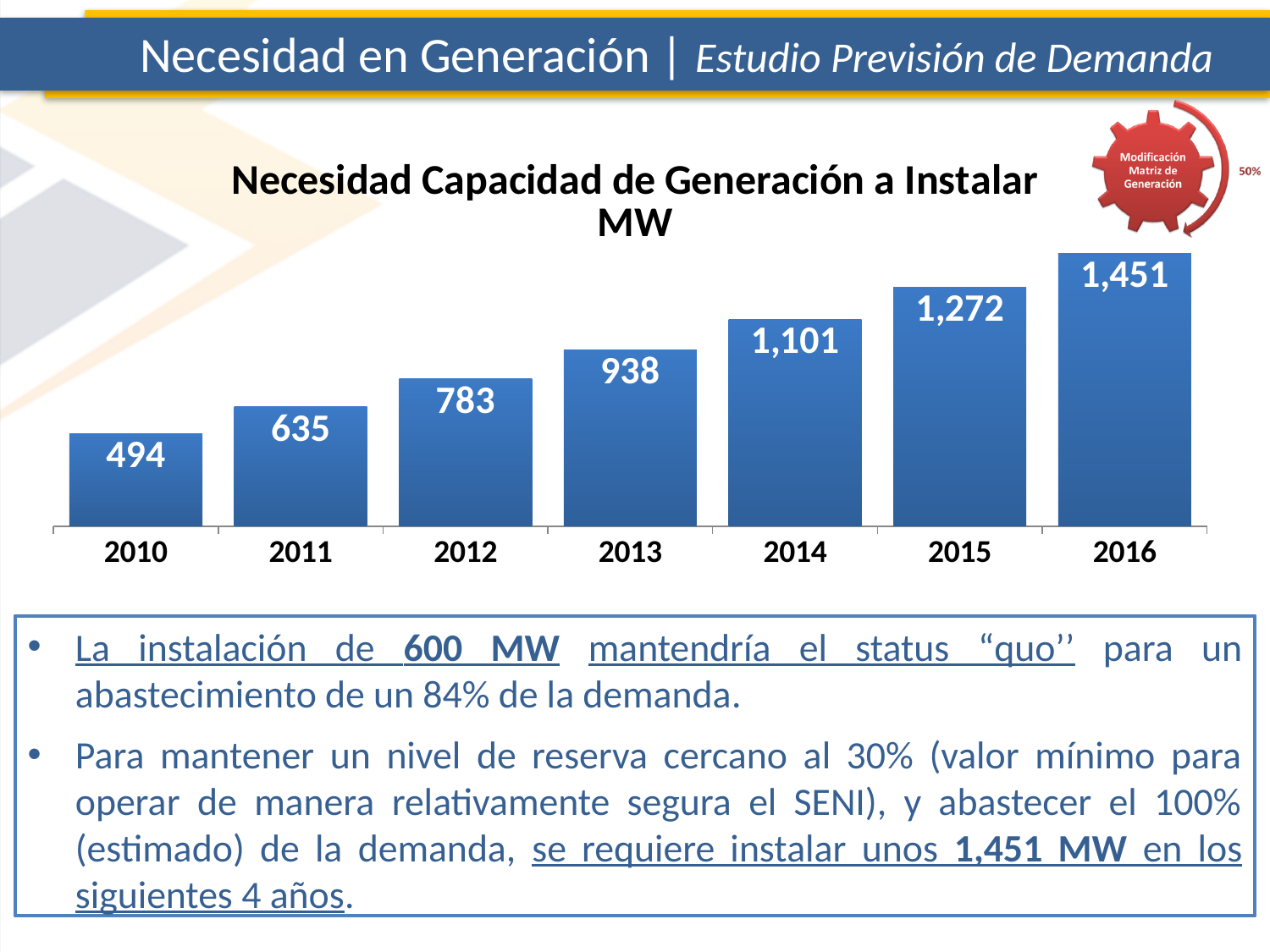
What is the title of the chart? Necesidad Capacidad de Generación a Instalar MW What is the difference between the values for 2016 and 2015? 179 Do the values rise or fall from 2010 to 2016? rise How many years are shown on the x axis? 7 What kind of chart is shown? bar chart Which year has the lowest value? 2010 What is the value for 2010? 494 Which year has the highest value? 2016 What is the value for 2016? 1,451 What is the difference between the values for 2012 and 2011? 148 What is the value for 2013? 938 Which is larger, the value for 2014 or the value for 2013? 2014